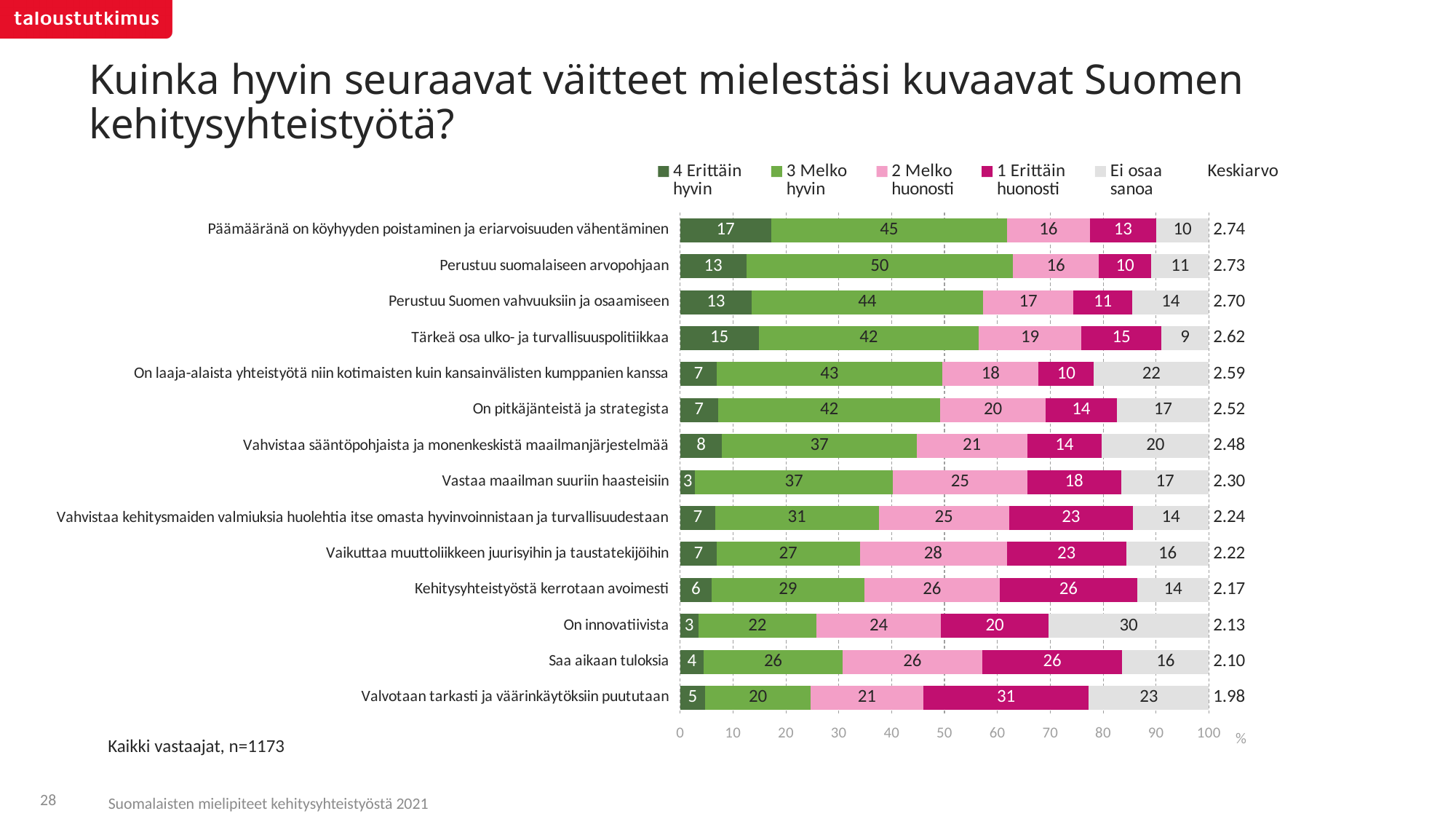
What is the difference between the '3 Melko hyvin' values for 'Perustuu suomalaiseen arvopohjaan' and 'Valvotaan tarkasti ja väärinkäytöksiin puututaan'? 30 How many response categories does the legend list (excluding the Keskiarvo column)? 5 Which is larger: the '1 Erittäin huonosti' value for 'Kehitysyhteistyöstä kerrotaan avoimesti' or for 'Tärkeä osa ulko- ja turvallisuuspolitiikkaa'? Kehitysyhteistyöstä kerrotaan avoimesti What is the combined share of '4 Erittäin hyvin' and '3 Melko hyvin' for 'Päämääränä on köyhyyden poistaminen ja eriarvoisuuden vähentäminen'? 62 How many statements (categories) are plotted in the chart? 14 What is the '1 Erittäin huonosti' value for 'Valvotaan tarkasti ja väärinkäytöksiin puututaan'? 31 What kind of chart is shown on the slide? Stacked bar chart Which statement has the lowest Keskiarvo value? Valvotaan tarkasti ja väärinkäytöksiin puututaan What is the Keskiarvo (mean) shown for 'On innovatiivista'? 2.13 Which statement has the highest '4 Erittäin hyvin' value? Päämääränä on köyhyyden poistaminen ja eriarvoisuuden vähentäminen Which statement has the highest 'Ei osaa sanoa' value? On innovatiivista What is the '3 Melko hyvin' value for 'Perustuu suomalaiseen arvopohjaan'? 50